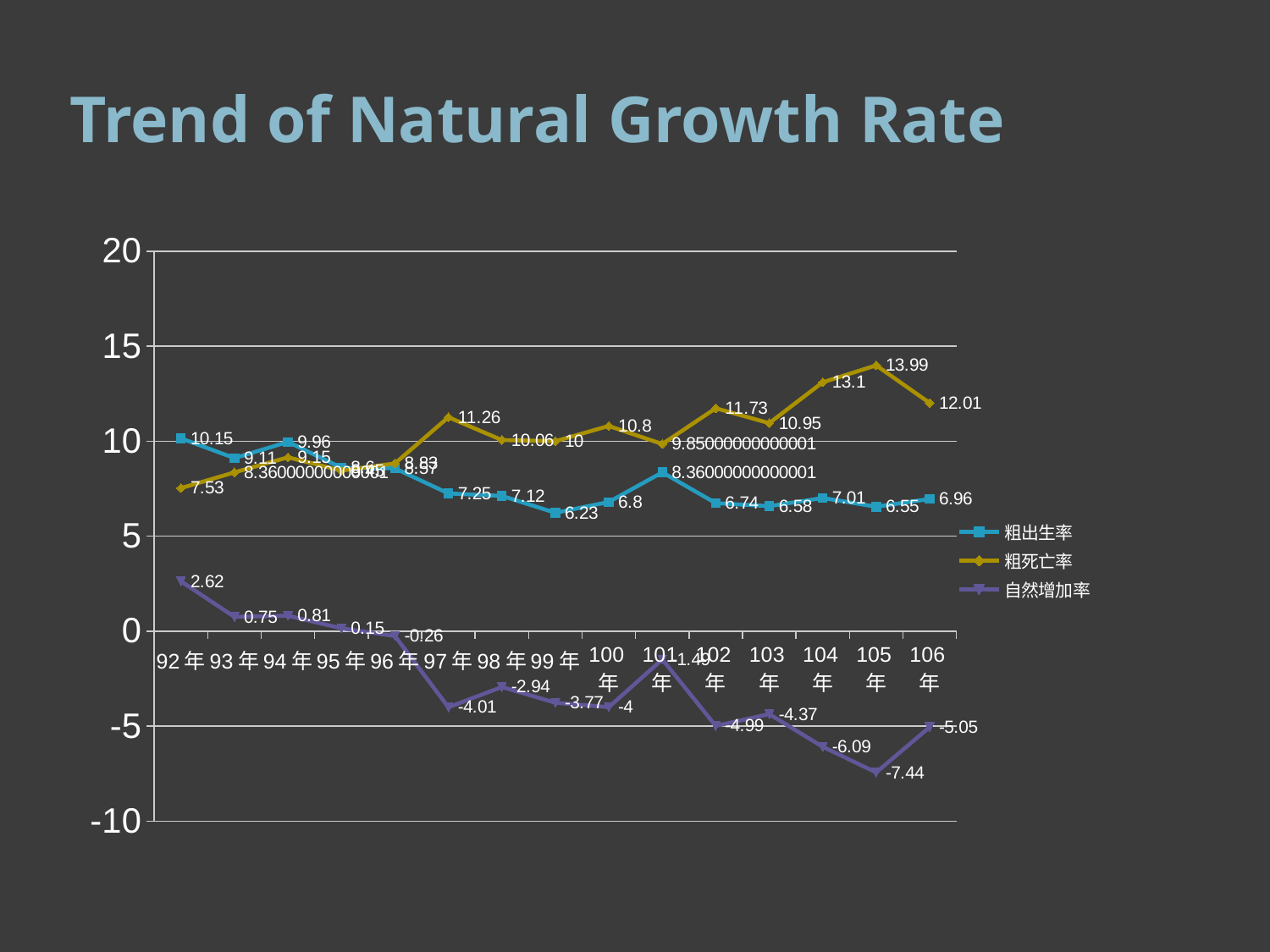
What is the value of 粗死亡率 in 105年? 13.99 What is the value of 粗出生率 in 92年? 10.15 In 92年, which is larger, 粗出生率 or 粗死亡率? 粗出生率 What is the title of the chart? Trend of Natural Growth Rate How many series does the legend list? 3 In which year is 粗死亡率 highest? 105年 In which year is 自然增加率 lowest? 105年 What is the difference between 粗死亡率 and 粗出生率 in 106年? 5.05 How many years are plotted along the x axis? 15 In which year is 粗出生率 lowest? 99年 What type of chart is shown on the slide? line chart What is the value of 自然增加率 in 105年? -7.44